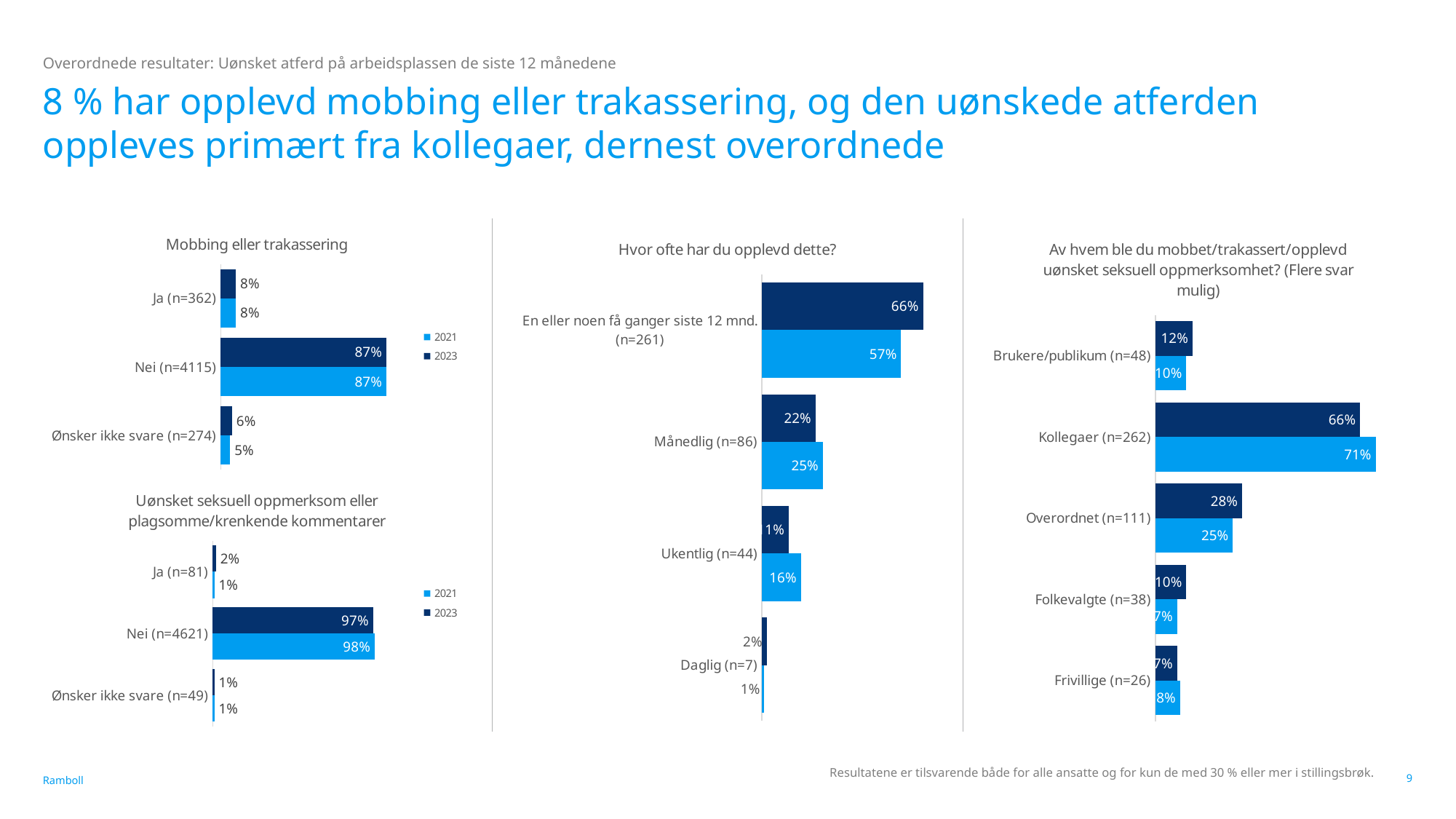
In the 'Mobbing eller trakassering' chart, what is the 2023 value for 'Ja (n=362)'? 8% In the 'Hvor ofte har du opplevd dette?' chart, what is the 2023 value for 'En eller noen få ganger siste 12 mnd. (n=261)'? 66% In the 'Hvor ofte har du opplevd dette?' chart, what is the difference between the 2021 and 2023 values for 'Månedlig (n=86)'? 3% In the 'Hvor ofte har du opplevd dette?' chart, which category has the highest 2021 value? En eller noen få ganger siste 12 mnd. (n=261) How many series does the legend of the 'Mobbing eller trakassering' chart list? 2 In the 'Av hvem ble du mobbet/trakassert/opplevd uønsket seksuell oppmerksomhet?' chart, which is larger for 'Overordnet (n=111)': the 2021 value or the 2023 value? 2023 In the 'Mobbing eller trakassering' chart, what is the 2021 value for 'Ønsker ikke svare (n=274)'? 5% In the 'Av hvem ble du mobbet/trakassert/opplevd uønsket seksuell oppmerksomhet?' chart, what is the 2021 value for 'Kollegaer (n=262)'? 71% In the 'Uønsket seksuell oppmerksom eller plagsomme/krenkende kommentarer' chart, what is the 2021 value for 'Nei (n=4621)'? 98% In the 'Mobbing eller trakassering' chart, what is the difference between the 2023 and 2021 values for 'Ønsker ikke svare (n=274)'? 1% In the 'Uønsket seksuell oppmerksom eller plagsomme/krenkende kommentarer' chart, what is the 2023 value for 'Ja (n=81)'? 2% In the 'Av hvem ble du mobbet/trakassert/opplevd uønsket seksuell oppmerksomhet?' chart, how many categories are shown? 5